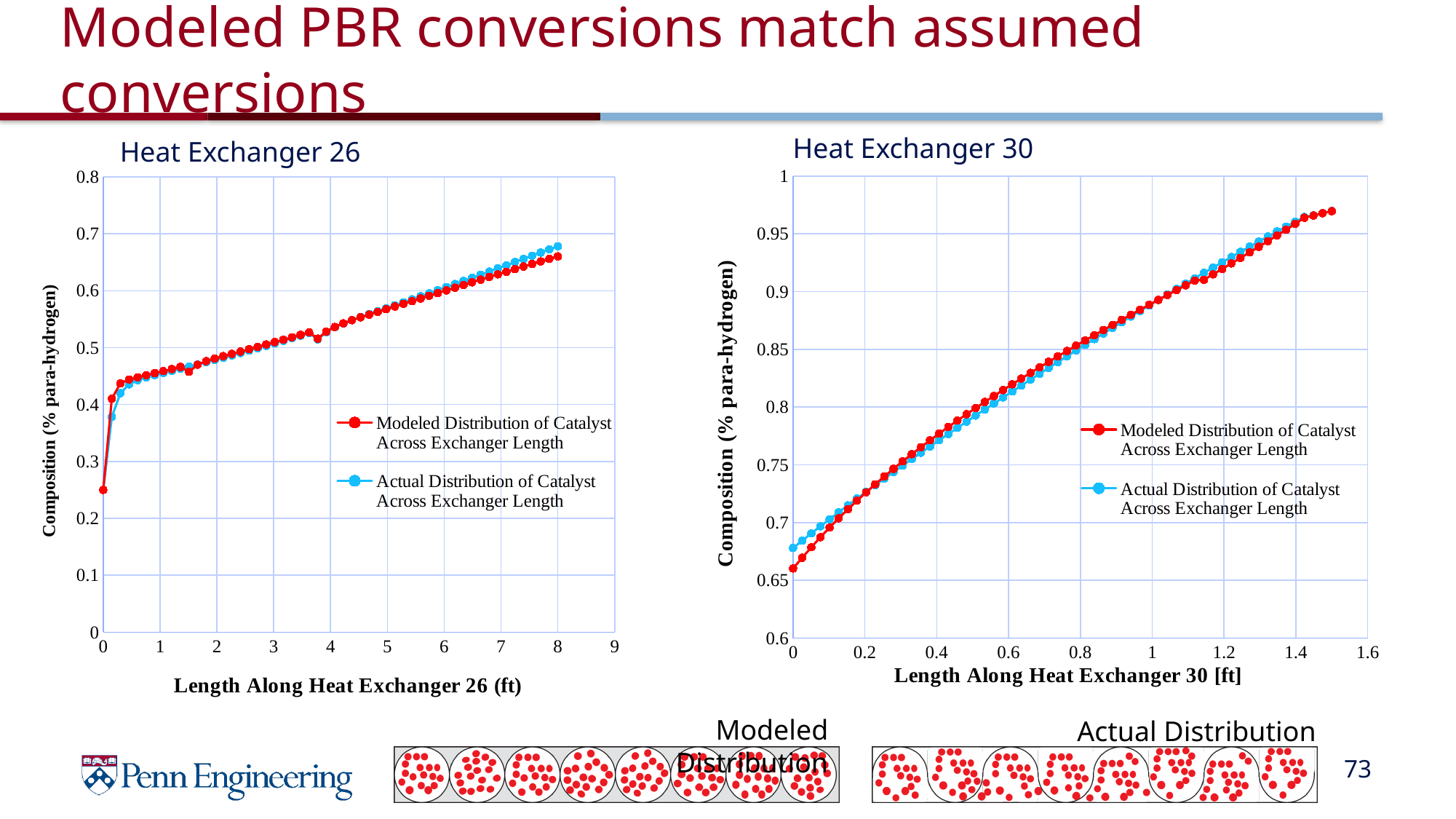
In the Heat Exchanger 26 chart, is the Modeled Distribution value at length 6 ft greater or less than 0.5? greater How many series does the legend of the Heat Exchanger 30 chart list? 2 In the Heat Exchanger 30 chart, do the values rise or fall as the length along the exchanger increases? rise What kind of chart is the Heat Exchanger 26 chart? line chart How many series does the legend of the Heat Exchanger 26 chart list? 2 In the Heat Exchanger 30 chart, is the Modeled Distribution value at length 0 ft greater or less than 0.7? less In the Heat Exchanger 26 chart, is the Modeled Distribution value at length 0 ft greater or less than 0.3? less What is the x-axis label of the Heat Exchanger 30 chart? Length Along Heat Exchanger 30 [ft] What kind of chart is the Heat Exchanger 30 chart? line chart In the Heat Exchanger 26 chart, do the values rise or fall as the length along the exchanger increases? rise In the Heat Exchanger 26 chart, which colour is used for the Actual Distribution of Catalyst Across Exchanger Length series? blue